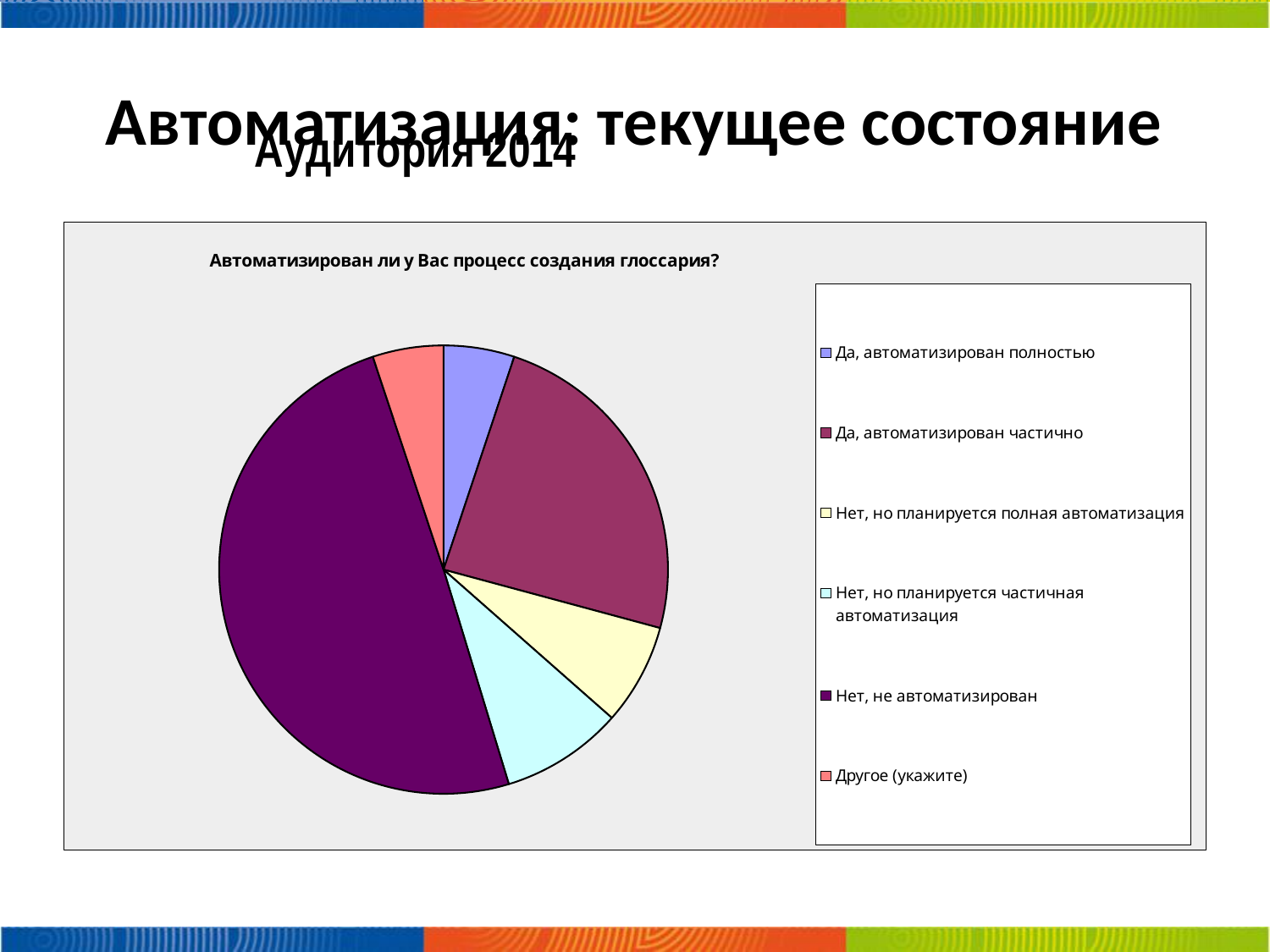
Which slice is larger: "Да, автоматизирован частично" or "Нет, но планируется полная автоматизация"? Да, автоматизирован частично Which slice is larger: "Нет, не автоматизирован" or "Да, автоматизирован частично"? Нет, не автоматизирован Which category has the largest slice of the pie? Нет, не автоматизирован What is the title of the chart? Автоматизирован ли у Вас процесс создания глоссария? How many categories does the pie chart have? 6 Which slice is larger: "Да, автоматизирован частично" or "Да, автоматизирован полностью"? Да, автоматизирован частично Which category is shown in dark purple in the legend? Нет, не автоматизирован What kind of chart is shown on the slide? pie chart